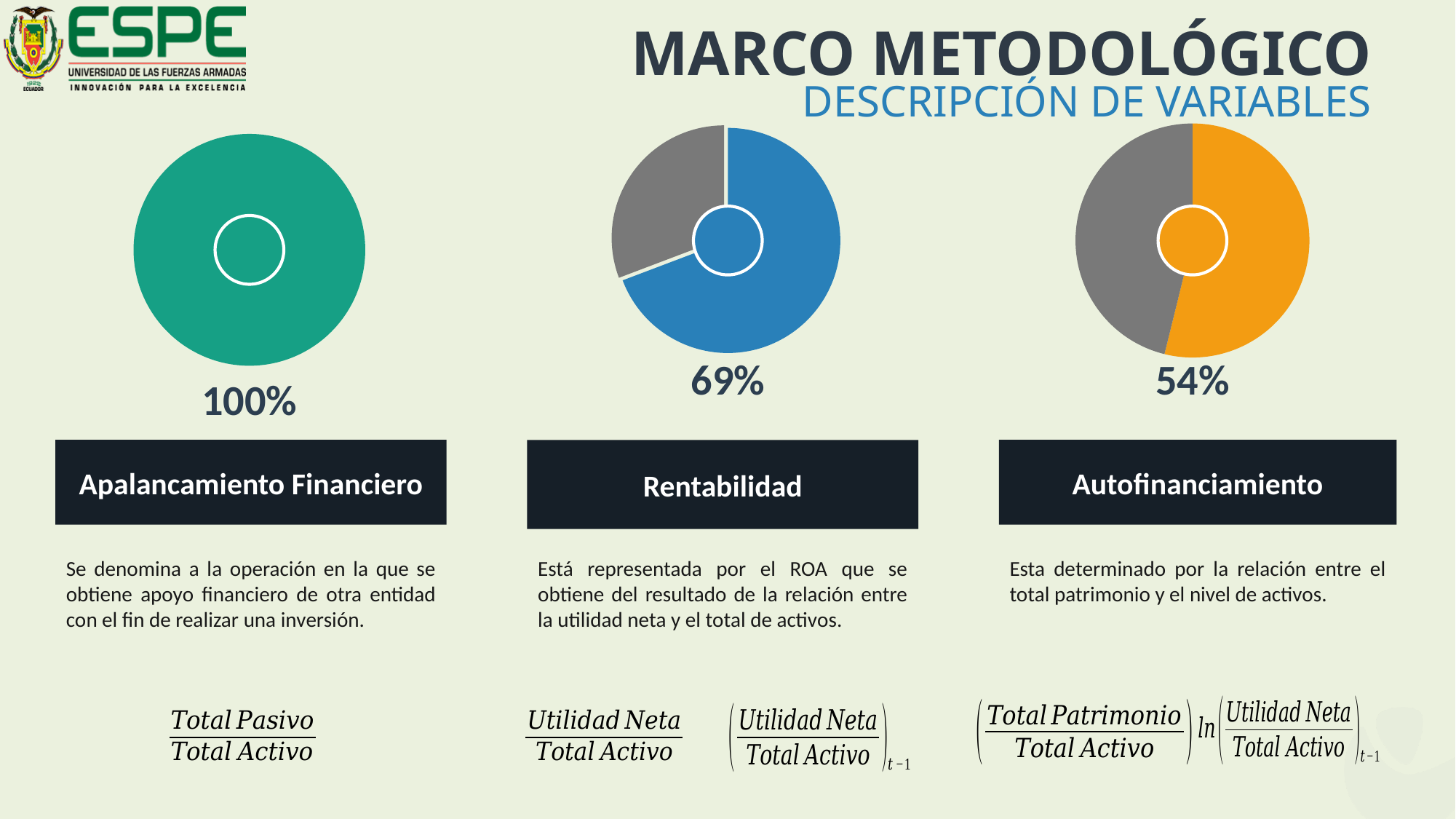
What percentage is shown for the Autofinanciamiento chart? 54% In the Rentabilidad chart, what share of the pie does the grey slice represent? 31% What is the difference between the percentage shown for Apalancamiento Financiero and the percentage shown for Rentabilidad? 31% Which of the three charts shows the lowest percentage? Autofinanciamiento Which of the three charts shows the highest percentage? Apalancamiento Financiero What percentage is shown for the Rentabilidad chart? 69% What is the difference between the percentage shown for Rentabilidad and the percentage shown for Autofinanciamiento? 15% What kind of chart is used for the Rentabilidad variable? Pie chart Which shows a larger percentage, the Rentabilidad chart or the Autofinanciamiento chart? Rentabilidad How many charts are shown on the slide? 3 What colour is the coloured slice in the Autofinanciamiento chart? Orange What percentage is shown for the Apalancamiento Financiero chart? 100%